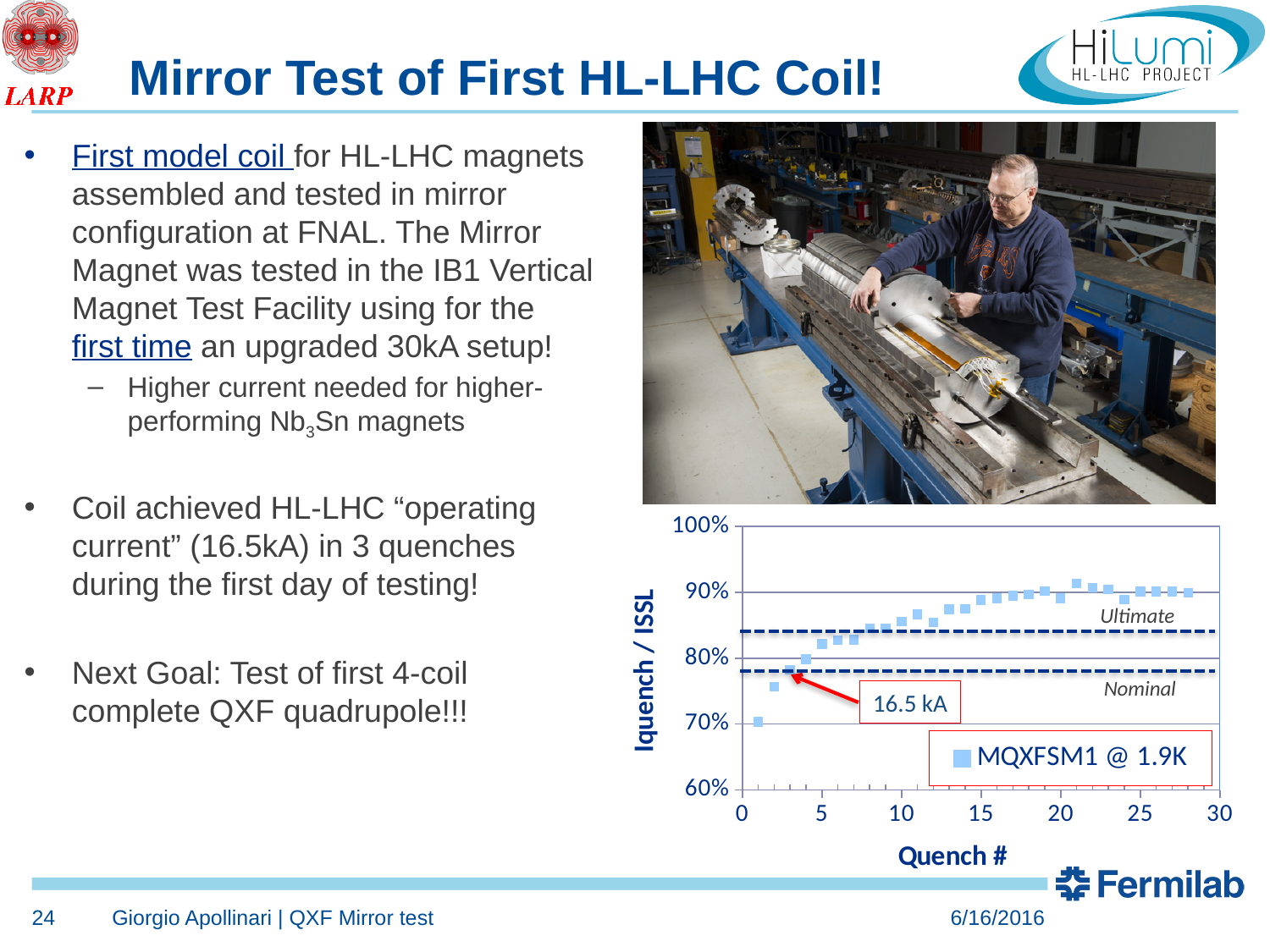
What are the labels of the two dashed horizontal lines in the chart? Ultimate and Nominal Which quench number has the lowest Iquench / ISSL value? 1 Is the Iquench / ISSL value for quench 1 greater or less than 80%? less Is the Iquench / ISSL value for quench 20 greater or less than 80%? greater Is the Nominal dashed line above or below 80% on the chart? below Which has the larger Iquench / ISSL value, quench 1 or quench 20? quench 20 What is the name of the series shown in the chart legend? MQXFSM1 @ 1.9K What kind of chart is shown on the slide? scatter chart How many data series does the chart legend list? 1 Do the Iquench / ISSL values generally rise or fall as the quench number increases? rise